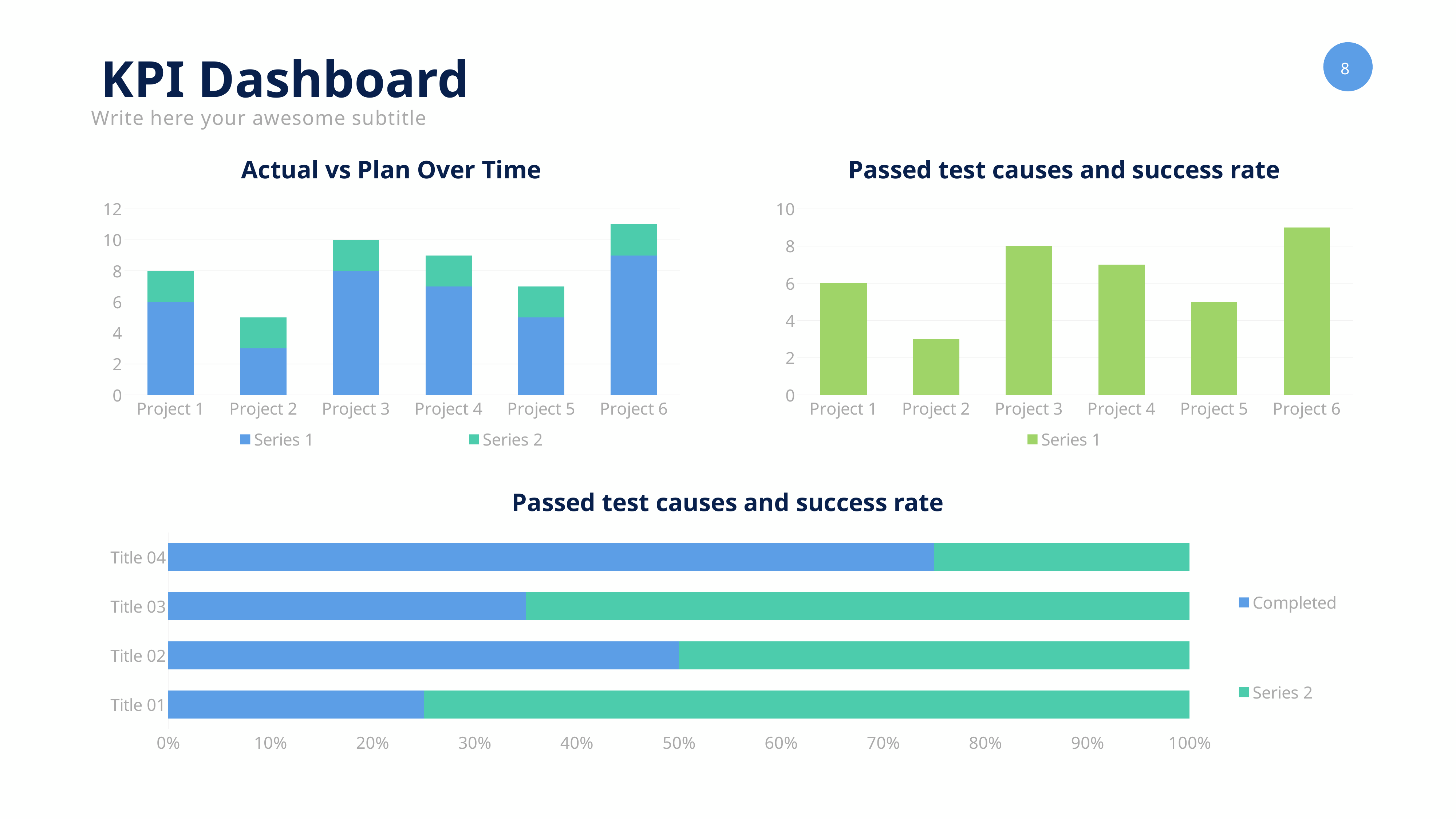
In the top-right 'Passed test causes and success rate' chart, how many projects are shown on the x axis? 6 In the 'Actual vs Plan Over Time' chart, what is the Series 1 value for Project 1? 6 In the bottom 'Passed test causes and success rate' chart, what is the Completed value for Title 02? 50% In the bottom 'Passed test causes and success rate' chart, is the Completed value for Title 04 greater or less than 70%? greater In the top-right 'Passed test causes and success rate' chart, which project has the highest value? Project 6 In the 'Actual vs Plan Over Time' chart, how many series does the legend list? 2 In the 'Actual vs Plan Over Time' chart, which project has the tallest stacked bar? Project 6 In the top-right 'Passed test causes and success rate' chart, which project has the lowest value? Project 2 In the 'Actual vs Plan Over Time' chart, what is the total height of the stacked bar for Project 3? 10 In the 'Actual vs Plan Over Time' chart, what is the Series 1 value for Project 3? 8 In the top-right 'Passed test causes and success rate' chart, what is the value for Project 1? 6 In the 'Actual vs Plan Over Time' chart, is the Series 1 value for Project 2 greater or less than 4? less